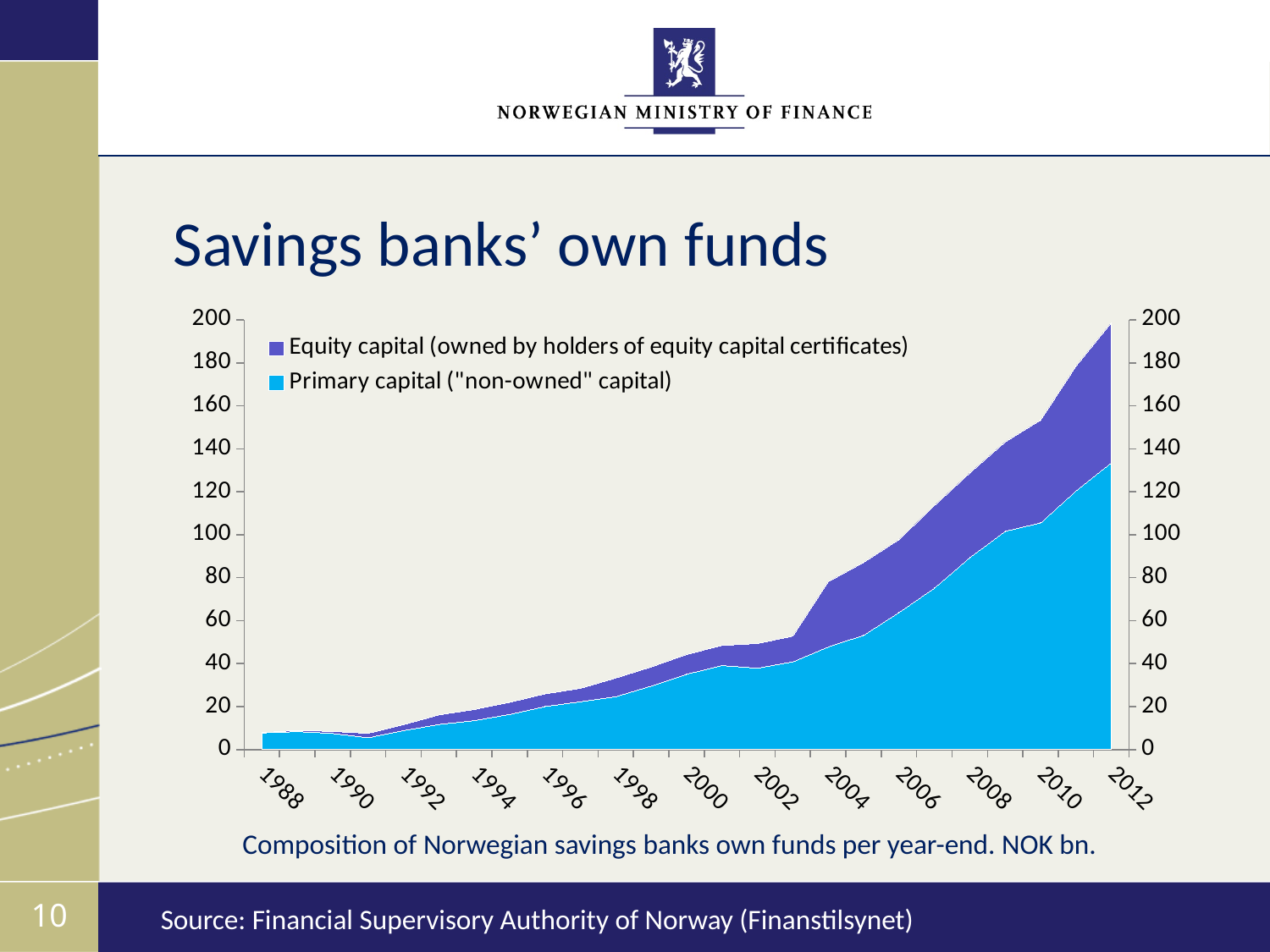
How many series does the legend list? 2 How many year labels are shown on the x axis? 13 In 2012, which is larger: primary capital or equity capital? Primary capital What is the title of the chart on the slide? Savings banks' own funds Is the value of primary capital in 2012 greater or less than 120? greater What kind of chart is shown on the slide? Stacked area chart Is the total of savings banks' own funds in 1988 greater or less than 20? less Which series is shown in the lighter blue colour at the bottom of the chart? Primary capital ("non-owned" capital) Is the total of savings banks' own funds in 2000 greater or less than 40? greater Do savings banks' total own funds rise or fall from 1988 to 2012? Rise